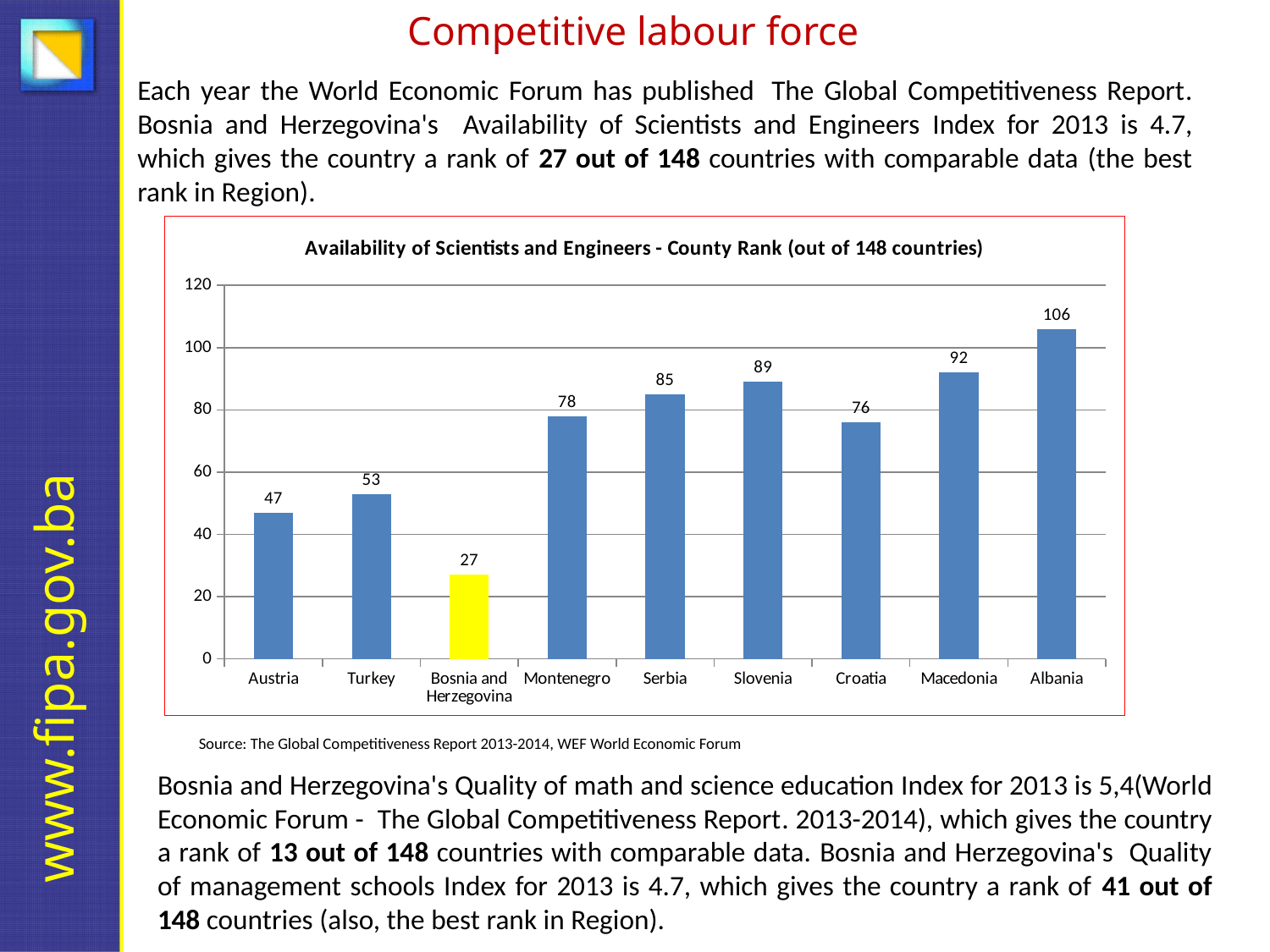
How many countries are shown in the chart? 9 What is the title of the chart? Availability of Scientists and Engineers - County Rank (out of 148 countries) Which country's bar is coloured yellow instead of blue? Bosnia and Herzegovina Which country has the highest bar in the chart? Albania What is the rank shown for Bosnia and Herzegovina? 27 Is the value for Montenegro greater or less than 60? greater Which has a larger value, Macedonia or Serbia? Macedonia What is the rank shown for Croatia? 76 What type of chart is shown on the slide? bar chart What is the difference between the values for Albania and Austria? 59 Which country has the lowest bar in the chart? Bosnia and Herzegovina What is the rank shown for Slovenia? 89